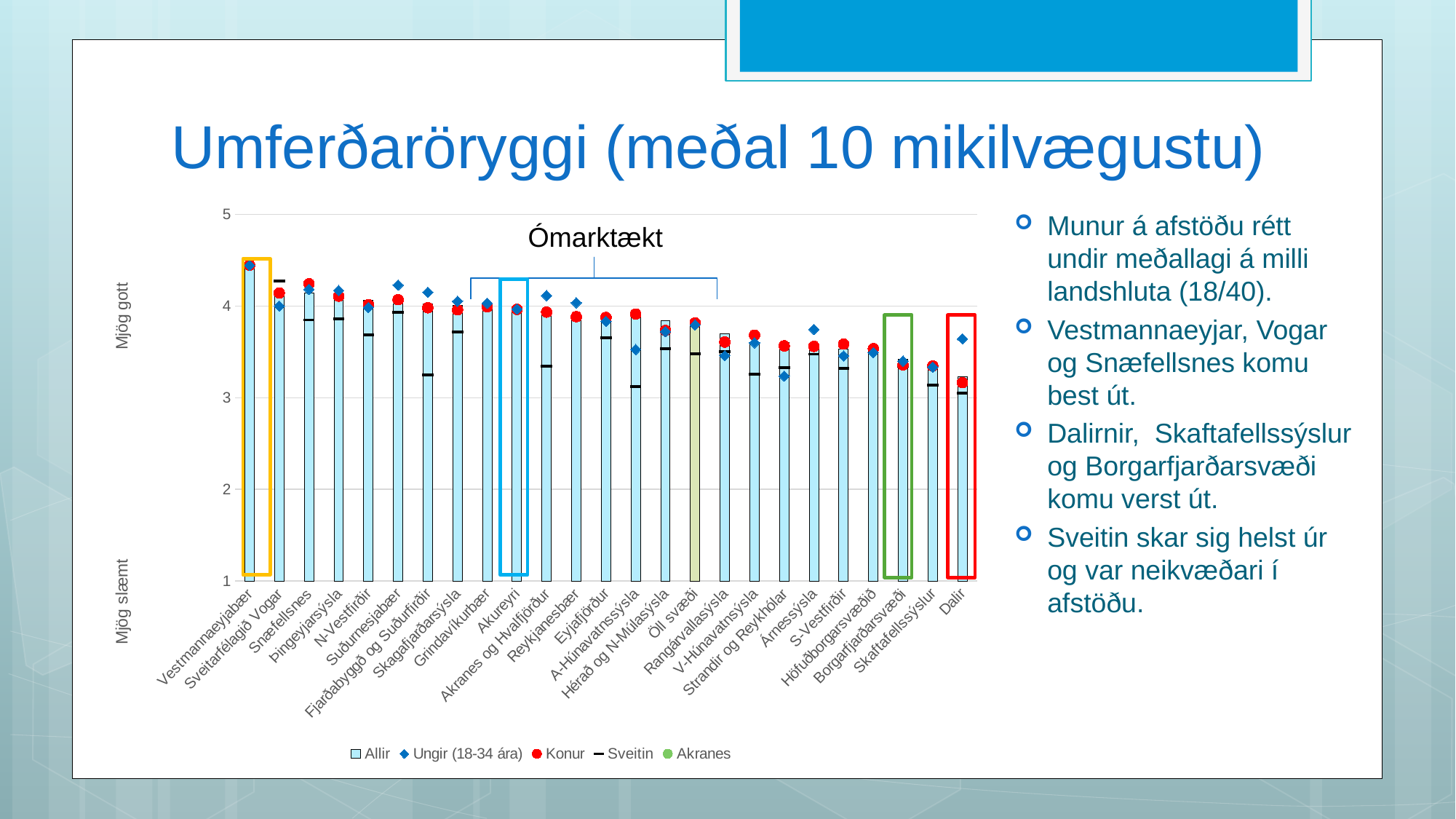
Is the Allir value for Dalir greater or less than 4? less Which has the larger Allir bar, Snæfellsnes or Árnessýsla? Snæfellsnes Do the Allir bars generally rise or fall from left to right along the x axis? fall Is the Allir value for Skaftafellssýslur greater or less than 3? greater How many series does the chart legend list? 5 How many categories (regions) are shown along the x axis of the chart? 25 Which series in the legend is shown with a blue diamond marker? Ungir (18-34 ára) Is the Allir value for Vestmannaeyjabær greater or less than 4? greater What label is written above the bracket spanning the middle group of bars in the chart? Ómarktækt What kind of chart is shown on the slide? bar chart Which category has the highest Allir bar in the chart? Vestmannaeyjabær Which category has the lowest Allir bar in the chart? Dalir